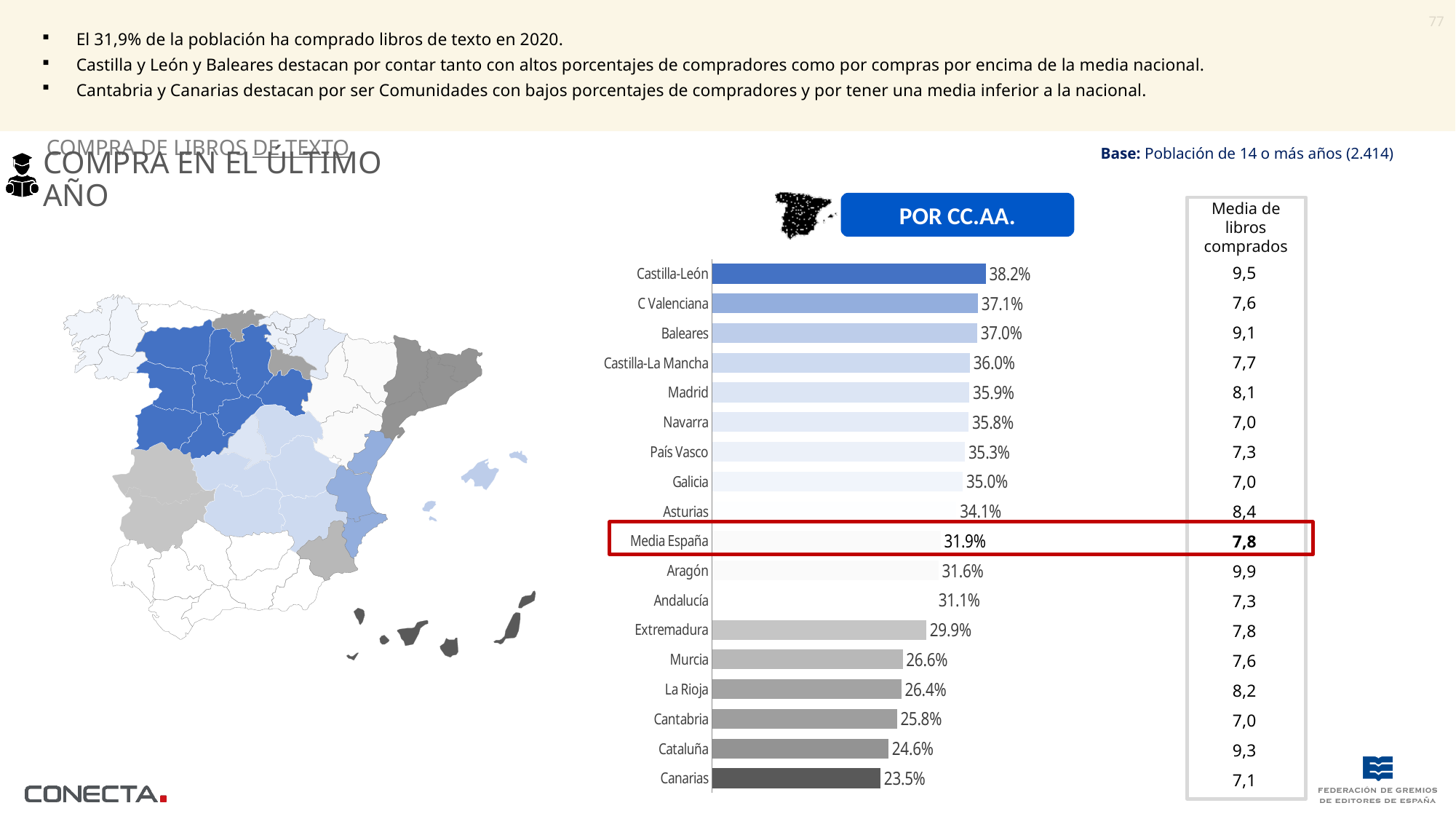
In the POR CC.AA. bar chart, what percentage is shown for Castilla-León? 38.2% In the POR CC.AA. bar chart, what percentage is shown for Cantabria? 25.8% In the POR CC.AA. bar chart, what percentage is shown for Media España? 31.9% In the POR CC.AA. bar chart, which region has the lowest percentage? Canarias In the POR CC.AA. bar chart, what is the difference in percentage points between Baleares and Media España? 5.1 In the POR CC.AA. bar chart, which has a higher percentage, Madrid or Galicia? Madrid What kind of chart is the POR CC.AA. chart? Bar chart In the POR CC.AA. bar chart, which region has the highest percentage? Castilla-León How many bars are plotted in the POR CC.AA. bar chart, including Media España? 18 In the 'Media de libros comprados' column, which region has the highest value? Aragón In the POR CC.AA. bar chart, what is the difference in percentage points between Castilla-León and Canarias? 14.7 In the POR CC.AA. bar chart, do the percentages rise or fall going from the top bar to the bottom bar? Fall